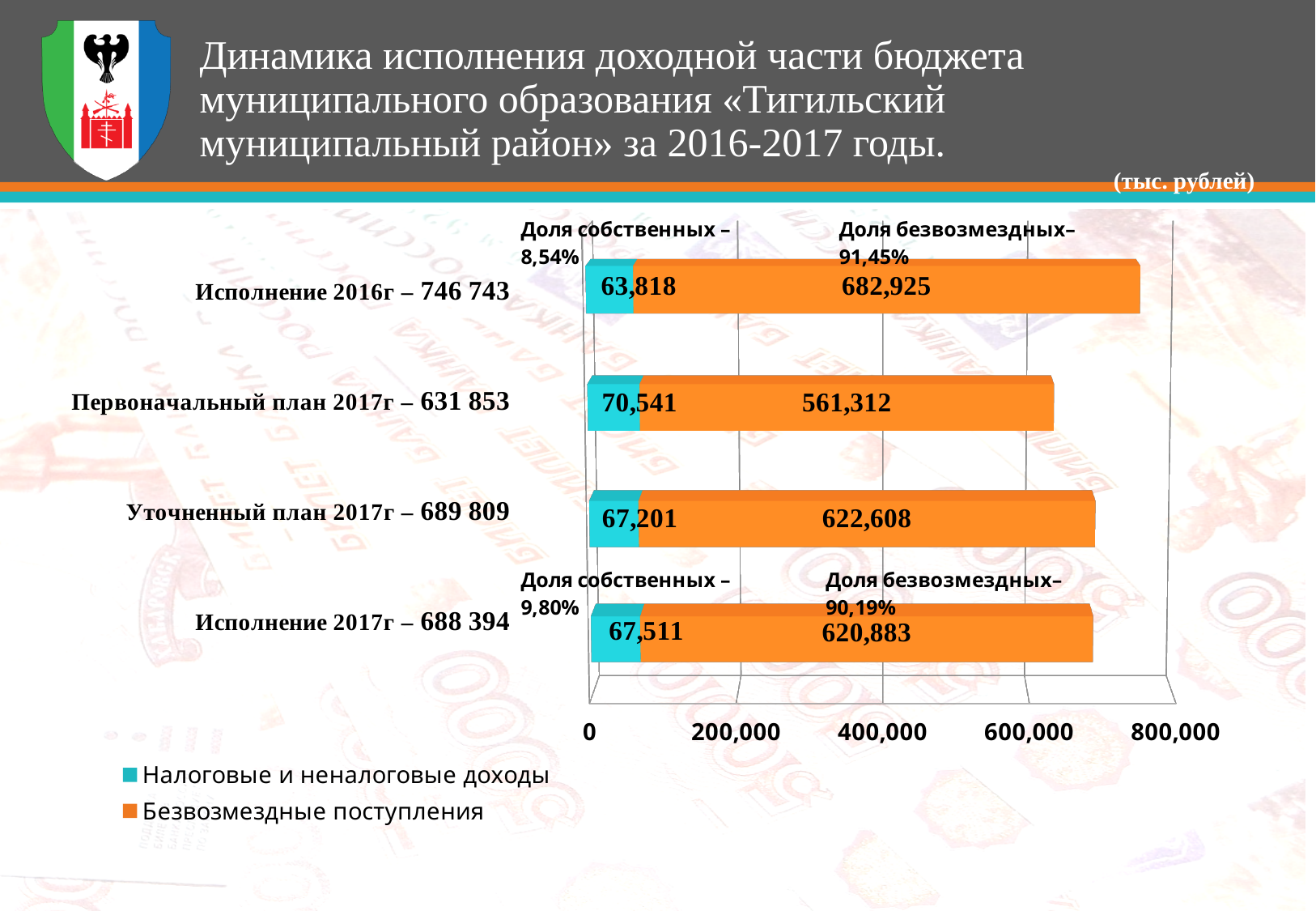
What is the value of Налоговые и неналоговые доходы for Исполнение 2016г? 63,818 How many categories are plotted in the chart? 4 What is the difference between Безвозмездные поступления for Исполнение 2016г and for Исполнение 2017г? 62,042 What kind of chart is shown on the slide? bar chart What is the value of Безвозмездные поступления for Первоначальный план 2017г? 561,312 What is the total of the stacked bar for Исполнение 2016г? 746 743 Which is larger: Безвозмездные поступления for Уточненный план 2017г or for Исполнение 2017г? Уточненный план 2017г How many series does the legend list? 2 Which category has the highest value for Налоговые и неналоговые доходы? Первоначальный план 2017г Which category has the lowest value for Безвозмездные поступления? Первоначальный план 2017г What is the value of Безвозмездные поступления for Уточненный план 2017г? 622,608 What is the value of Налоговые и неналоговые доходы for Исполнение 2017г? 67,511